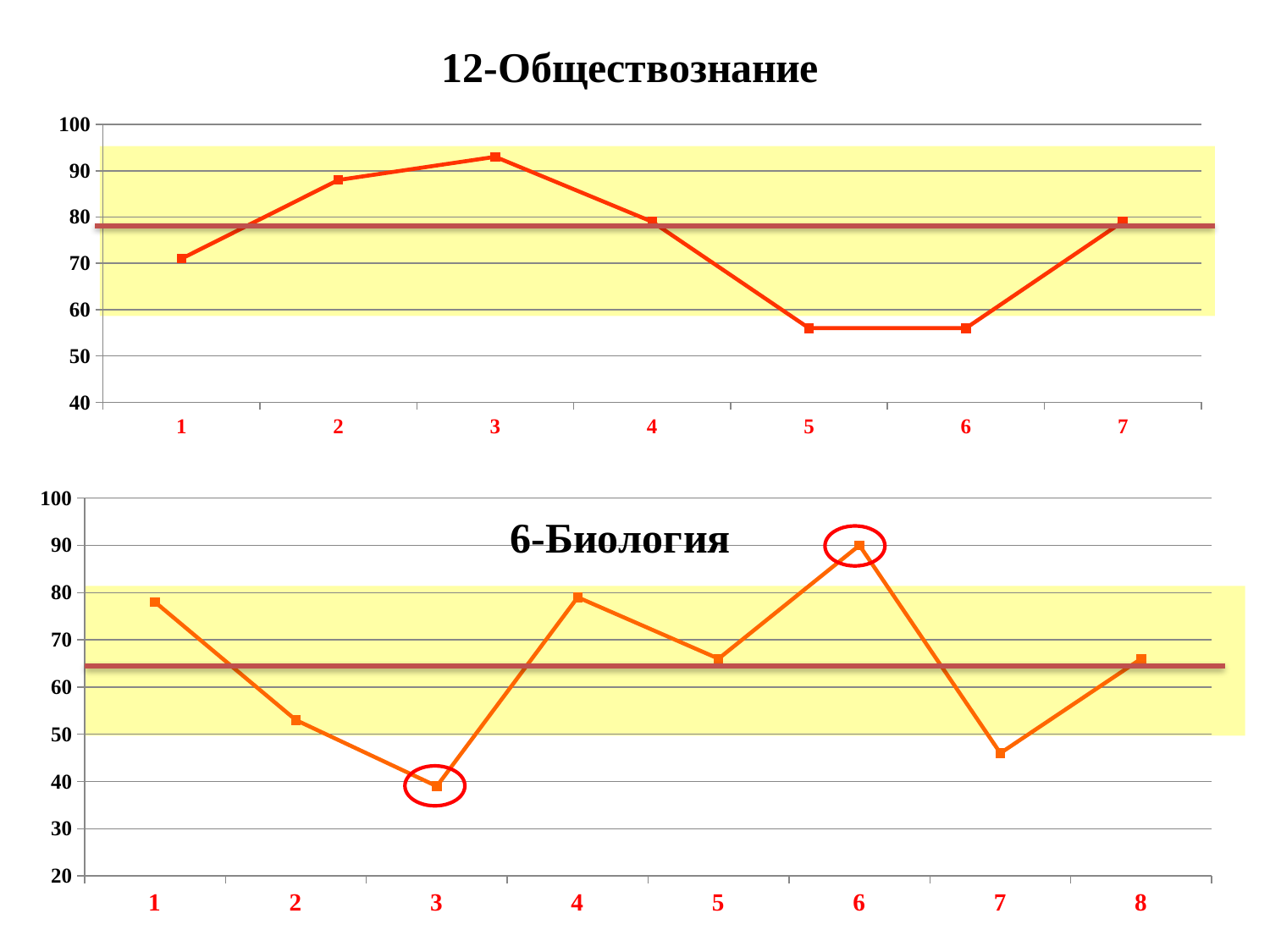
In the bottom chart (6-Биология), is the value for category 7 greater or less than 50? less In the bottom chart (6-Биология), which x-axis category has the highest value? 6 In the top chart (12-Обществознание), do the values rise or fall from category 1 to category 3? rise What kind of chart is the top chart titled 12-Обществознание? line chart In the bottom chart (6-Биология), how many points are plotted along the x axis? 8 In the top chart (12-Обществознание), which has the larger value, category 1 or category 3? 3 In the top chart (12-Обществознание), which x-axis category has the highest value? 3 In the top chart (12-Обществознание), is the value for category 5 greater or less than 60? less In the bottom chart (6-Биология), is the value for category 6 greater or less than 80? greater In the top chart (12-Обществознание), how many points are plotted along the x axis? 7 In the bottom chart (6-Биология), which x-axis category has the lowest value? 3